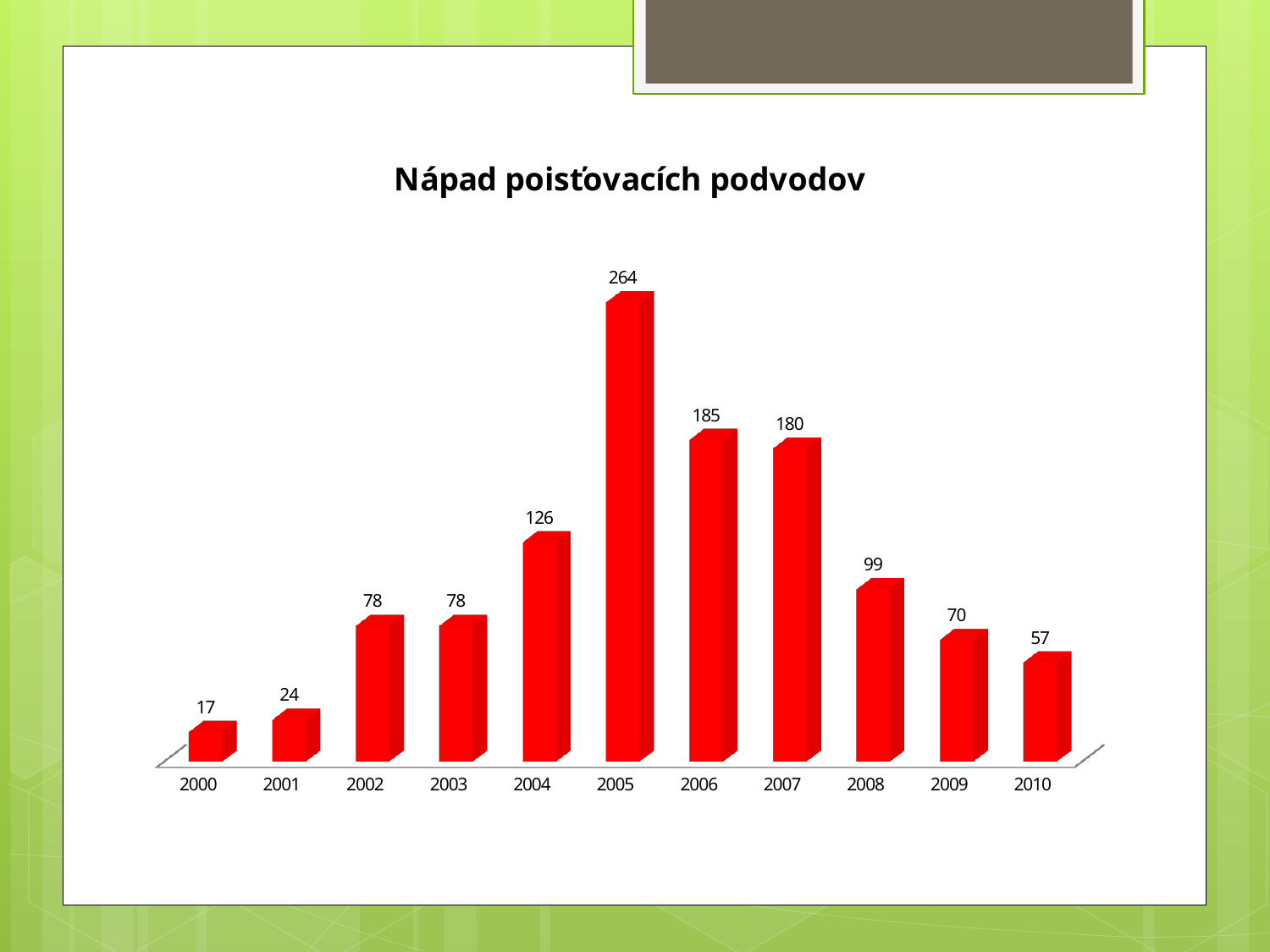
What kind of chart is this? bar chart Do the values rise or fall from 2005 to 2010? fall Which year has the highest value? 2005 What is the value for 2005? 264 How many years are shown on the x axis? 11 Which is larger, the value for 2006 or the value for 2007? 2006 What is the value for 2008? 99 What is the difference between the values for 2004 and 2003? 48 What is the title of the chart? Nápad poisťovacích podvodov What is the value for 2000? 17 What is the difference between the values for 2005 and 2006? 79 Which year has the lowest value? 2000